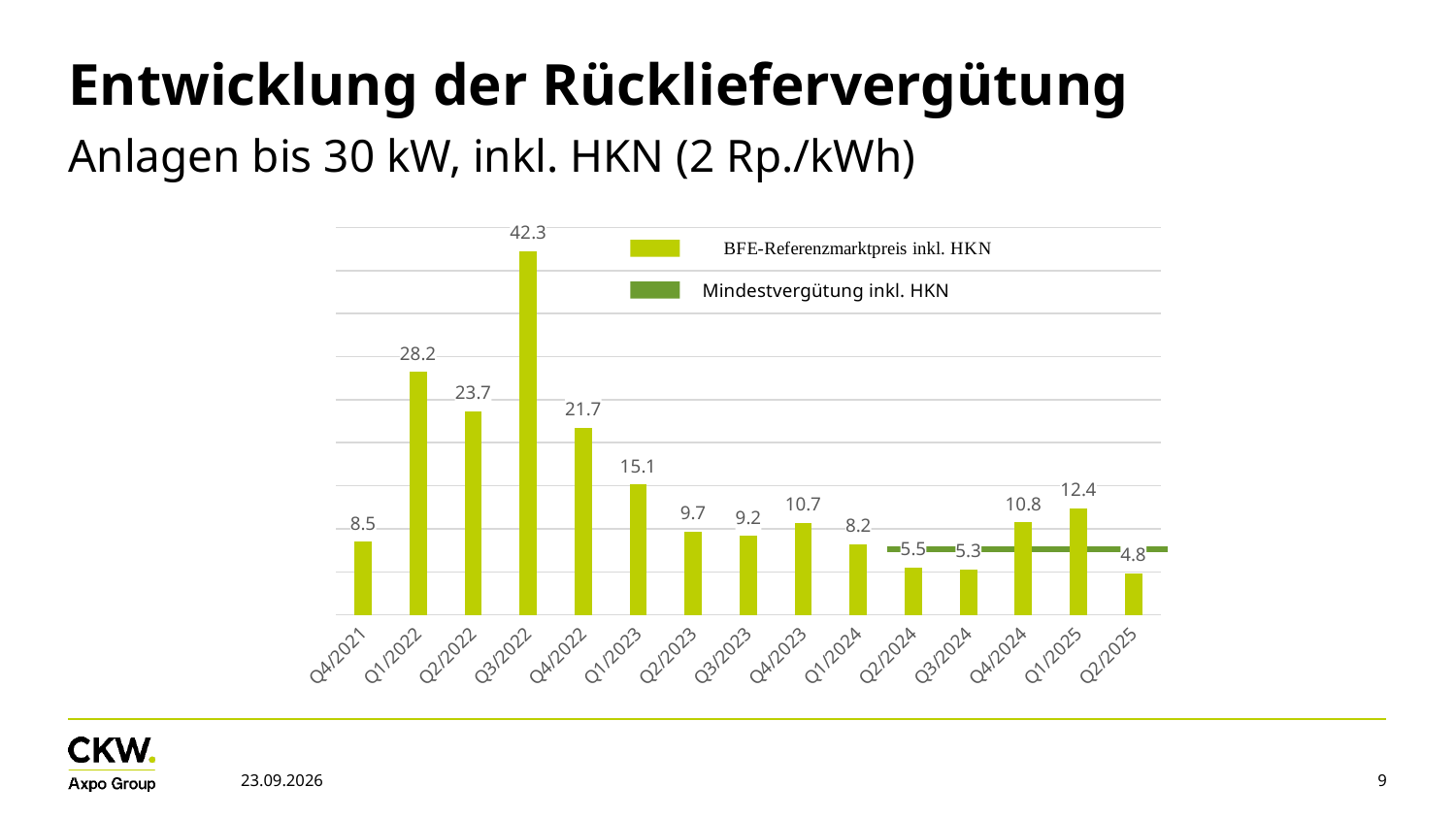
How many quarters are shown on the x axis? 15 What is the difference between the values for Q4/2024 and Q3/2024? 5.5 What is the value shown for Q1/2025? 12.4 What is the value shown for Q4/2021? 8.5 What kind of chart is shown on the slide? Bar chart What is the BFE-Referenzmarktpreis inkl. HKN value for Q3/2022? 42.3 Which quarter has the lowest BFE-Referenzmarktpreis inkl. HKN? Q2/2025 What is the difference between the values for Q3/2022 and Q1/2022? 14.1 Which quarter has the highest BFE-Referenzmarktpreis inkl. HKN? Q3/2022 Do the bar values rise or fall from Q3/2022 to Q1/2024? Fall How many series does the legend list? 2 Which is larger, the value for Q2/2023 or the value for Q3/2023? Q2/2023